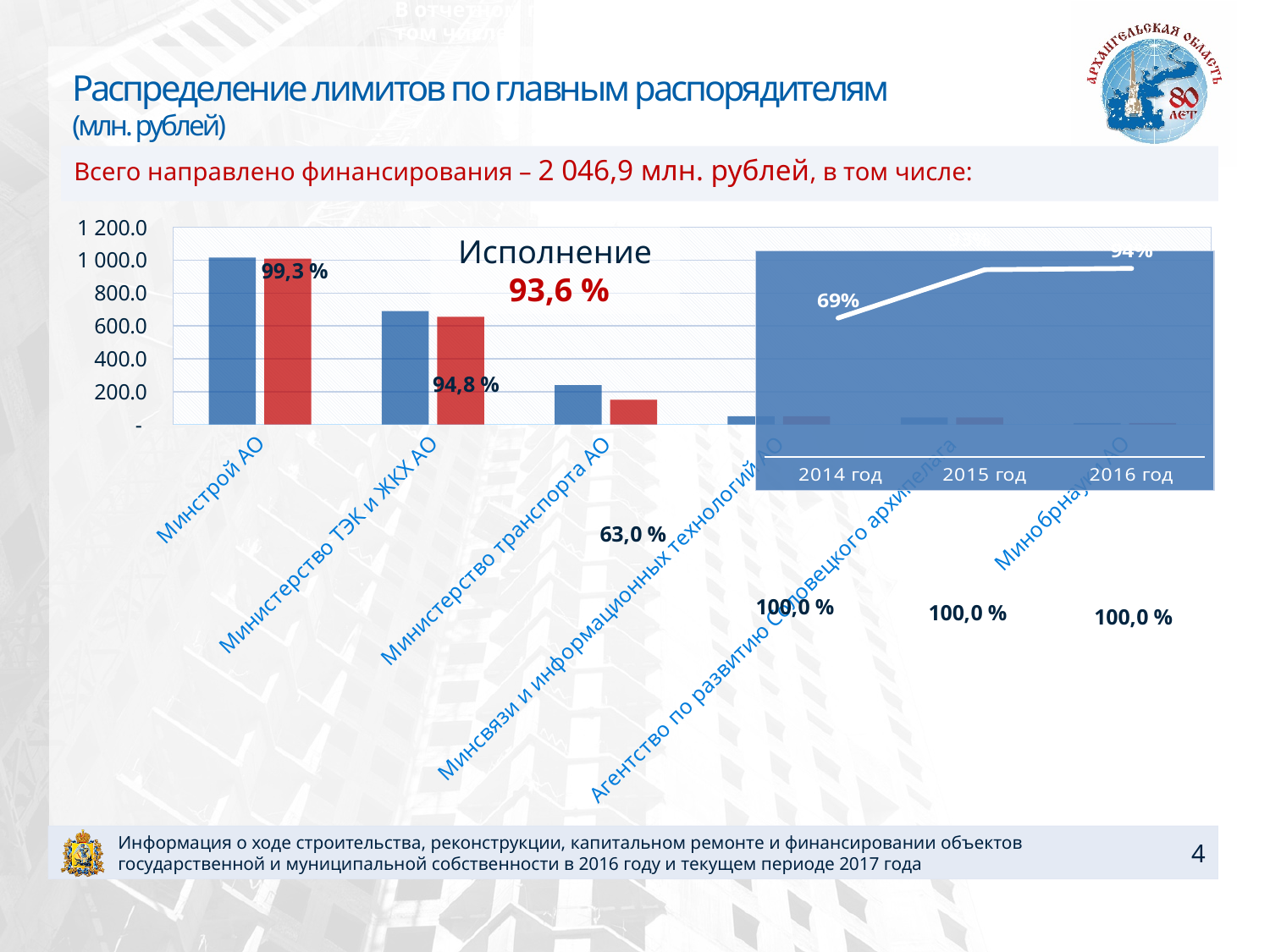
In the bar chart on the left, is the blue bar for Минстрой АО greater or less than 800.0? greater In the bar chart on the left, how many categories (ministries/agencies) are shown on the x axis? 6 In the bar chart on the left, what percentage label is shown for Министерство ТЭК и ЖКХ АО? 94,8 % In the line chart on the right, what value is shown for 2014 год? 69% In the bar chart on the left, which category has the tallest bars? Минстрой АО In the bar chart on the left, what percentage label is shown for Министерство транспорта АО? 63,0 % In the line chart on the right, do the values rise or fall from 2014 год to 2016 год? rise In the bar chart on the left, is the blue bar for Министерство ТЭК и ЖКХ АО greater or less than 800.0? less In the line chart on the right, how many years are shown on the x axis? 3 In the bar chart on the left, what percentage label is shown for Минстрой АО? 99,3 % In the line chart on the right, what value is shown for 2016 год? 94% What kind of chart is the large chart on the left showing the ministries? bar chart